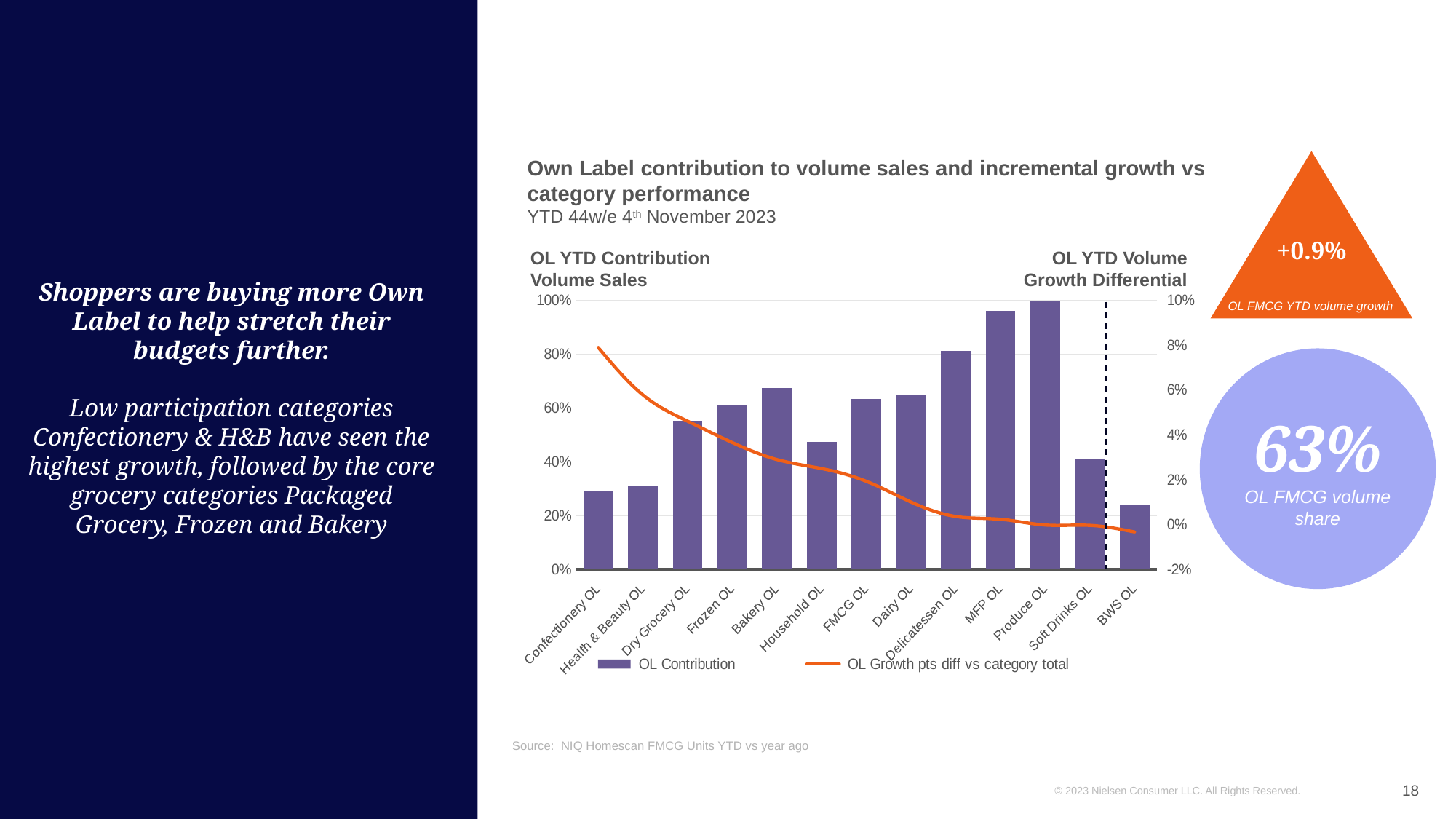
How many categories are shown on the x axis of the chart? 13 Which category has the highest OL Contribution bar? Produce OL Is the OL Contribution value for Household OL greater or less than 40%? greater How many series does the chart legend list? 2 Which category has the lowest OL Contribution bar? BWS OL What kind of chart is shown on the slide? A bar chart combined with a line Is the OL Contribution value for Confectionery OL greater or less than 40%? less Which has a larger OL Contribution bar, Bakery OL or Household OL? Bakery OL What are the two entries in the chart legend? OL Contribution; OL Growth pts diff vs category total Does the OL Growth pts diff vs category total line rise or fall from left to right across the categories? It falls Which has a larger OL Contribution bar, MFP OL or Delicatessen OL? MFP OL